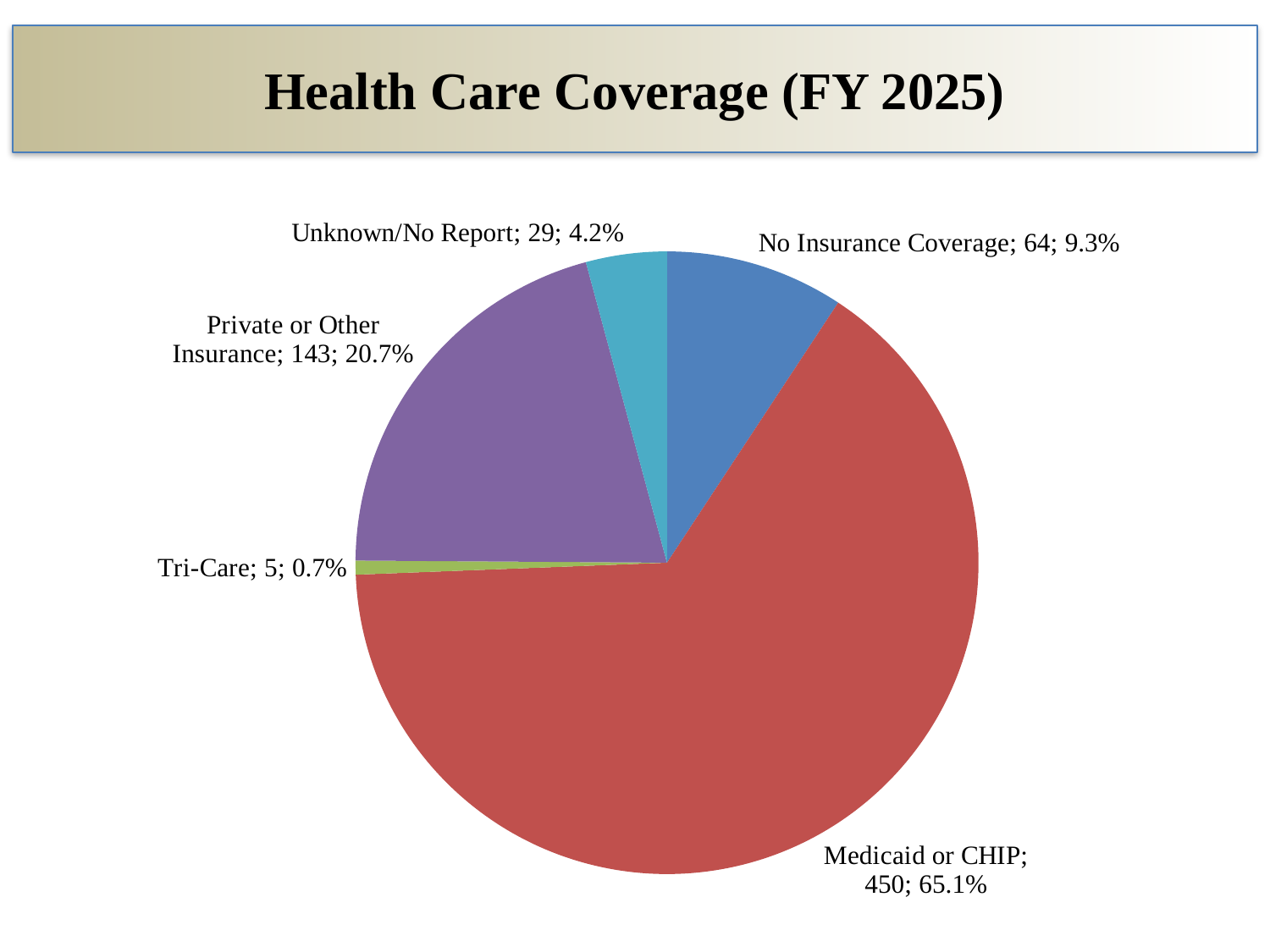
What is the count for Medicaid or CHIP? 450 What is the count for No Insurance Coverage? 64 What colour is the Medicaid or CHIP slice? red Which category has the largest slice? Medicaid or CHIP Which is larger, the count for Unknown/No Report or the count for Tri-Care? Unknown/No Report What percentage share does Unknown/No Report have? 4.2% How many slices does the pie chart have? 5 What type of chart is shown on the slide? pie chart What is the difference in count between Private or Other Insurance and No Insurance Coverage? 79 Which category has the smallest slice? Tri-Care What is the title of the chart? Health Care Coverage (FY 2025) What percentage share does Private or Other Insurance have? 20.7%